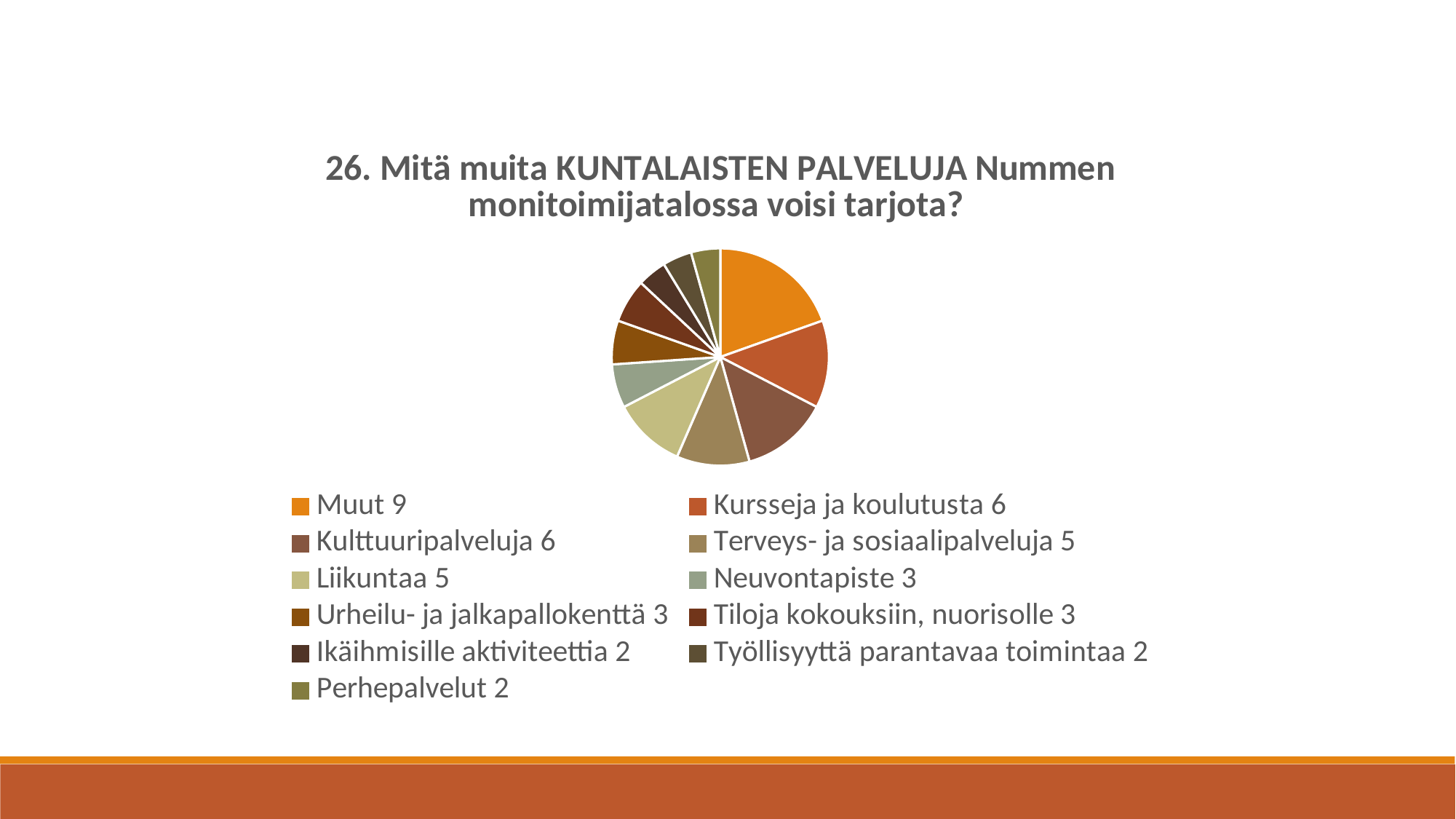
What is the difference between the values for Muut and Liikuntaa? 4 How many categories does the pie chart have? 11 What is the title of the chart? 26. Mitä muita KUNTALAISTEN PALVELUJA Nummen monitoimijatalossa voisi tarjota? What is the difference between the values for Kulttuuripalveluja and Ikäihmisille aktiviteettia? 4 What is the value for Muut? 9 What is the total of all the values shown in the pie chart's legend? 46 What is the value for Kursseja ja koulutusta? 6 What kind of chart is shown on the slide? pie chart What is the value for Neuvontapiste? 3 What is the value for Perhepalvelut? 2 Which category has the largest slice of the pie chart? Muut Which is larger, the value for Terveys- ja sosiaalipalveluja or the value for Tiloja kokouksiin, nuorisolle? Terveys- ja sosiaalipalveluja